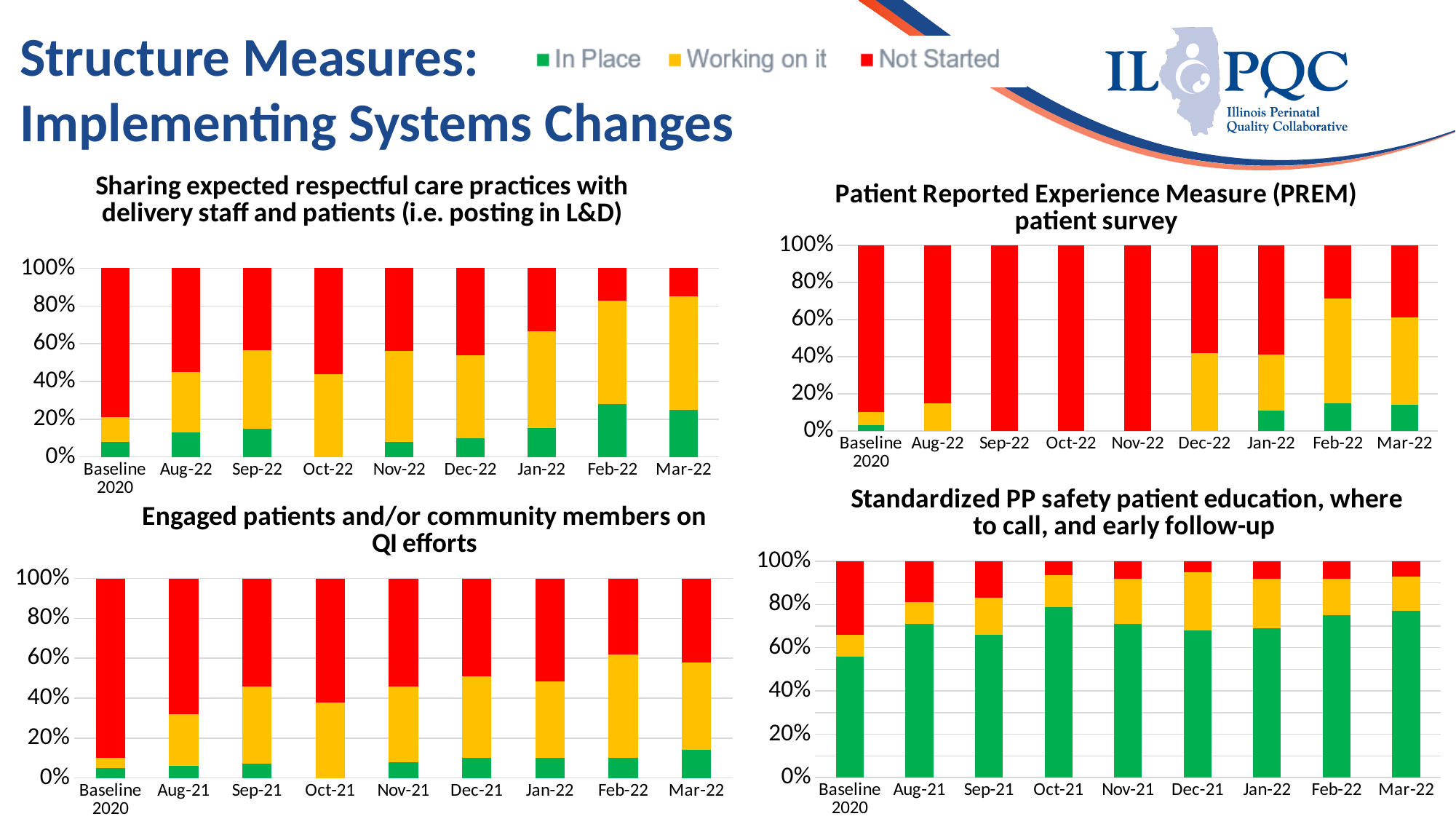
What kind of chart is used for the 'Patient Reported Experience Measure (PREM) patient survey'? Stacked bar chart In the 'Patient Reported Experience Measure (PREM) patient survey' chart, how many periods are entirely Not Started (100% red)? 3 In the 'Standardized PP safety patient education' chart, which period has the lowest In Place share? Baseline 2020 What is the title of the bottom-left chart? Engaged patients and/or community members on QI efforts In the 'Engaged patients and/or community members on QI efforts' chart, which has the larger In Place share: Baseline 2020 or Mar-22? Mar-22 In the 'Sharing expected respectful care practices' chart, how many time periods are shown on the x axis? 9 In the 'Patient Reported Experience Measure (PREM) patient survey' chart, is the Working on it share for Feb-22 greater or less than 40%? greater In the 'Sharing expected respectful care practices' chart, does the Not Started share rise or fall from Baseline 2020 to Mar-22? Fall How many series does the legend at the top of the slide list? 3 According to the legend, which colour represents 'Not Started'? Red In the 'Sharing expected respectful care practices' chart, is the Not Started share for Baseline 2020 greater or less than 60%? greater In the 'Standardized PP safety patient education' chart, is the In Place value for Baseline 2020 greater or less than 40%? greater